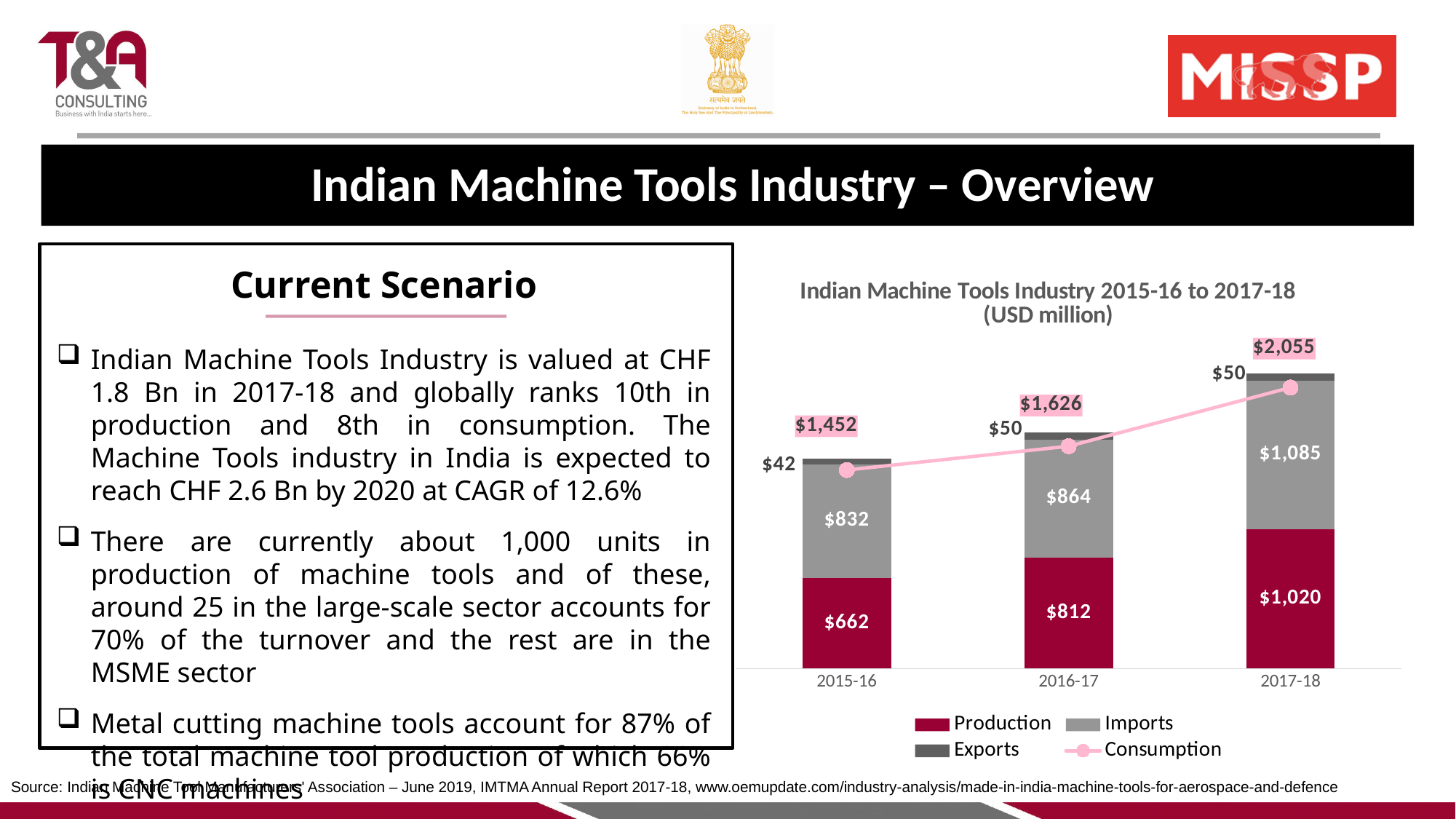
Which year has the lowest Production value? 2015-16 How many series does the legend list? 4 What is the Production value for 2017-18? $1,020 Does the Consumption line rise or fall from 2015-16 to 2017-18? Rise What is the Exports value for 2015-16? $42 What is the difference between the Production values for 2017-18 and 2015-16? $358 Which year has the highest Consumption value? 2017-18 What kind of chart is this? Stacked bar chart with a line What is the Consumption value for 2016-17? $1,626 How many years are shown on the x axis? 3 Which is larger in 2017-18, Production or Imports? Imports What is the Imports value for 2016-17? $864